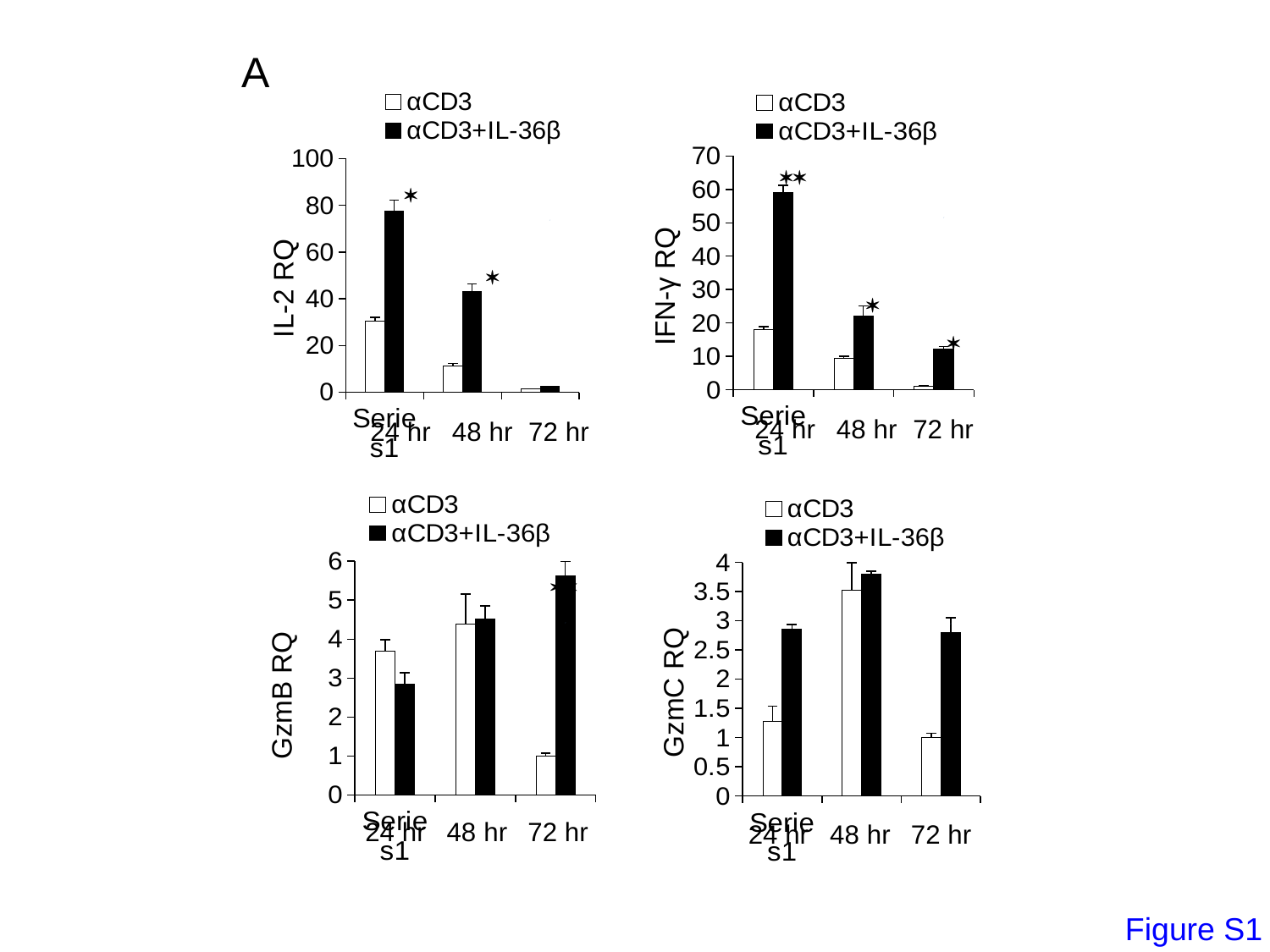
In the GzmC RQ chart (bottom right), at which time point is the αCD3 bar highest? 48 hr In the GzmC RQ chart (bottom right), is the αCD3+IL-36β value at 48 hr greater or less than 3? greater In the IFN-γ RQ chart (top right), do the αCD3+IL-36β values rise or fall from 24 hr to 72 hr? fall How many series does the legend of the IL-2 RQ chart (top left) list? 2 In the IFN-γ RQ chart (top right), is the αCD3+IL-36β value at 24 hr greater or less than 50? greater In the GzmB RQ chart (bottom left), which series has the larger value at 72 hr, αCD3 or αCD3+IL-36β? αCD3+IL-36β What kind of chart is the GzmC RQ chart (bottom right)? bar chart In the IL-2 RQ chart (top left), is the αCD3+IL-36β value at 24 hr greater or less than 60? greater In the IFN-γ RQ chart (top right), at which time point is the αCD3 bar lowest? 72 hr In the IL-2 RQ chart (top left), at which time point is the αCD3+IL-36β bar highest? 24 hr